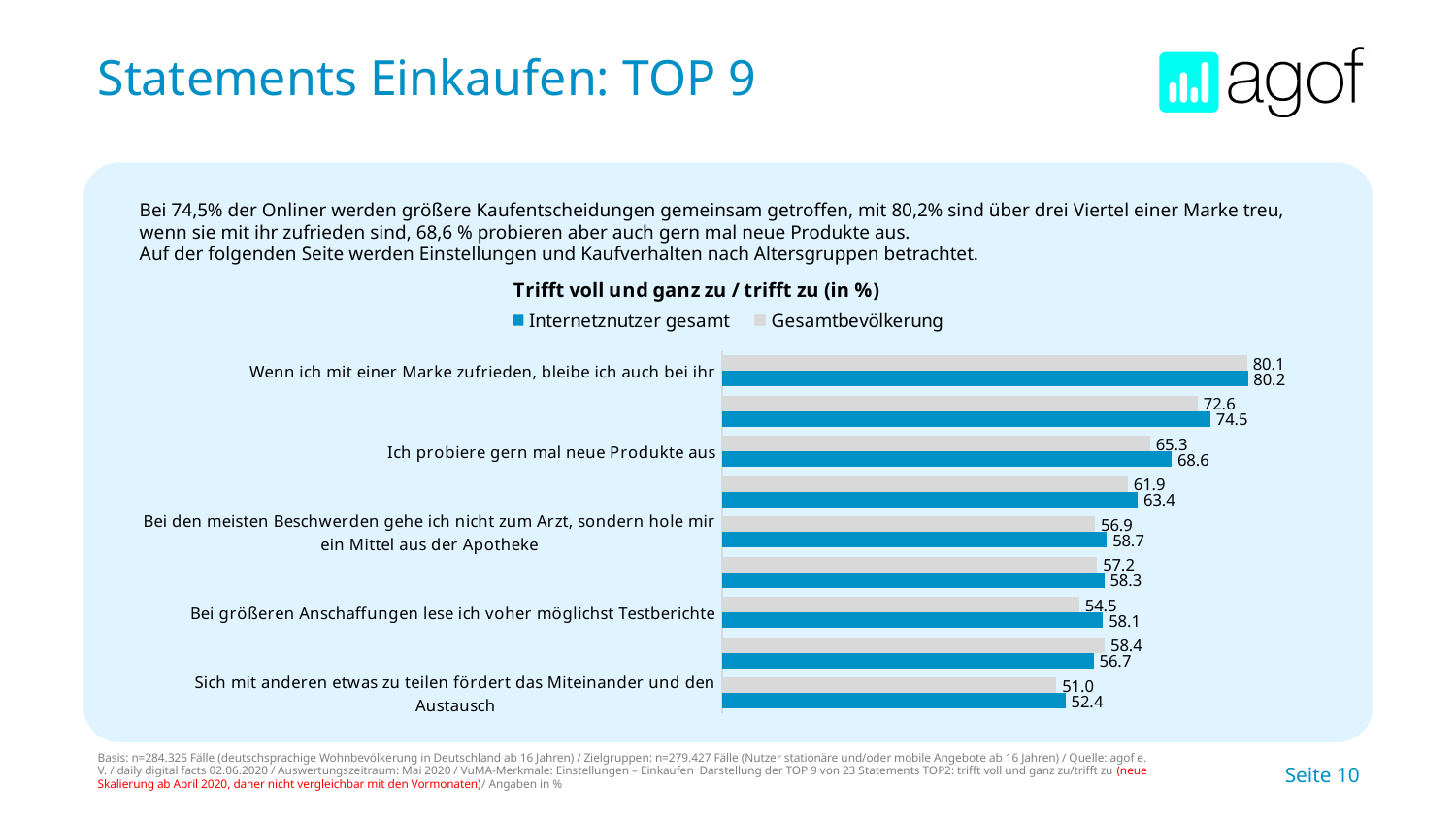
How many series does the chart legend list? 2 How many statements (categories) are plotted in the chart? 9 For the statement "Bei den meisten Beschwerden gehe ich nicht zum Arzt, sondern hole mir ein Mittel aus der Apotheke", which series has the larger value, Internetznutzer gesamt or Gesamtbevölkerung? Internetznutzer gesamt What type of chart is shown on the slide? bar chart What is the title of the chart? Trifft voll und ganz zu / trifft zu (in %) What is the value for Internetznutzer gesamt for the statement "Bei größeren Anschaffungen lese ich voher möglichst Testberichte"? 58.1 Which statement has the highest value for Internetznutzer gesamt? Wenn ich mit einer Marke zufrieden, bleibe ich auch bei ihr What is the value for Internetznutzer gesamt for the statement "Wenn ich mit einer Marke zufrieden, bleibe ich auch bei ihr"? 80.2 What is the difference between Internetznutzer gesamt and Gesamtbevölkerung for the statement "Ich probiere gern mal neue Produkte aus"? 3.3 What is the value for Gesamtbevölkerung for the statement "Ich probiere gern mal neue Produkte aus"? 65.3 What is the value for Gesamtbevölkerung for the statement "Sich mit anderen etwas zu teilen fördert das Miteinander und den Austausch"? 51.0 Which statement has the lowest value for Gesamtbevölkerung? Sich mit anderen etwas zu teilen fördert das Miteinander und den Austausch